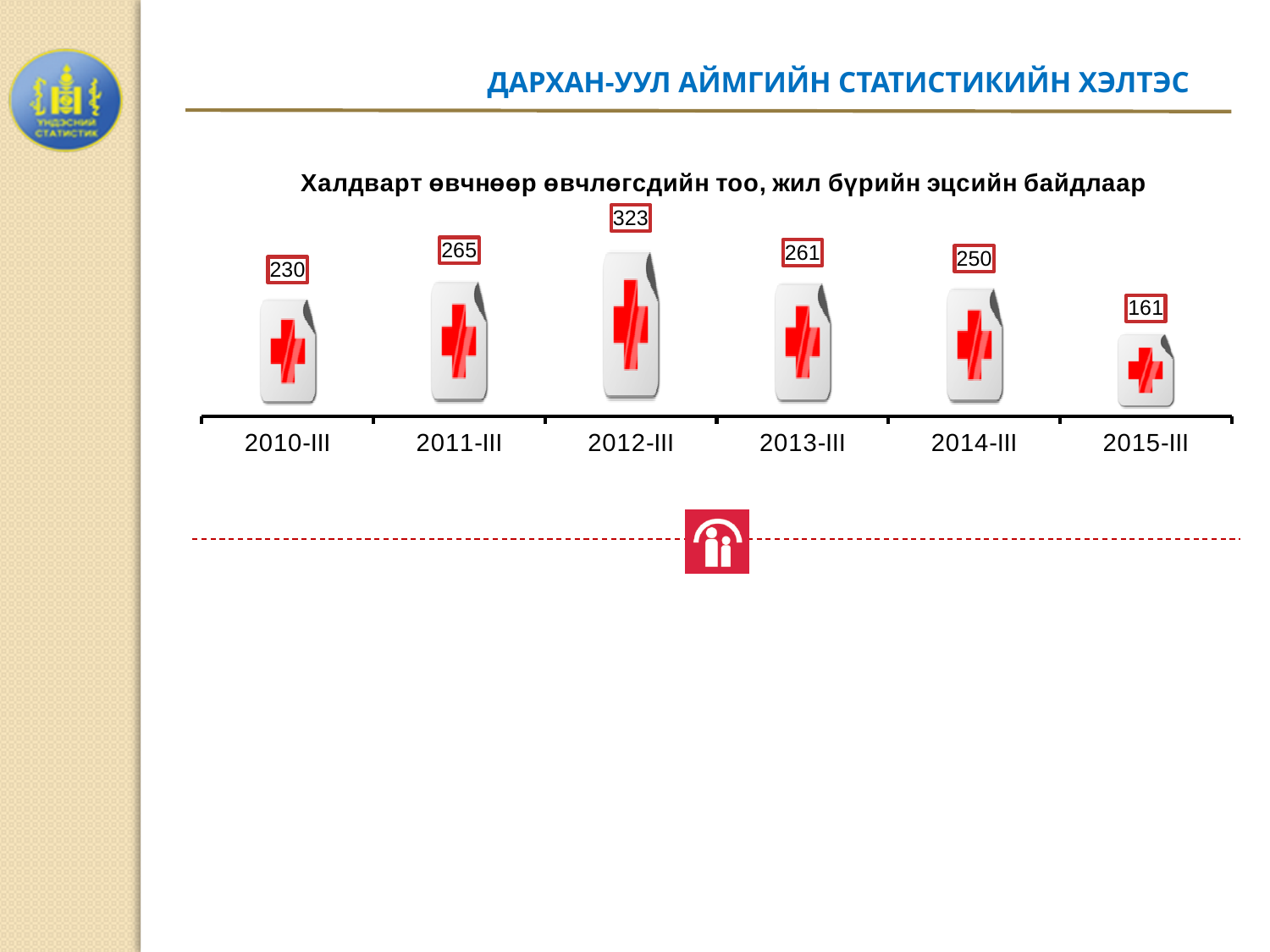
Which period has the lowest value? 2015-III Which period has the highest value? 2012-III What kind of chart is this? bar chart What is the title of the chart? Халдварт өвчнөөр өвчлөгсдийн тоо, жил бүрийн эцсийн байдлаар What is the difference between the values for 2012-III and 2015-III? 162 Do the values rise or fall from 2012-III to 2015-III? fall Which is larger, the value for 2013-III or the value for 2014-III? 2013-III How many periods are shown on the x axis? 6 What is the value for 2012-III? 323 What is the value for 2010-III? 230 What is the difference between the values for 2011-III and 2010-III? 35 What is the value for 2015-III? 161